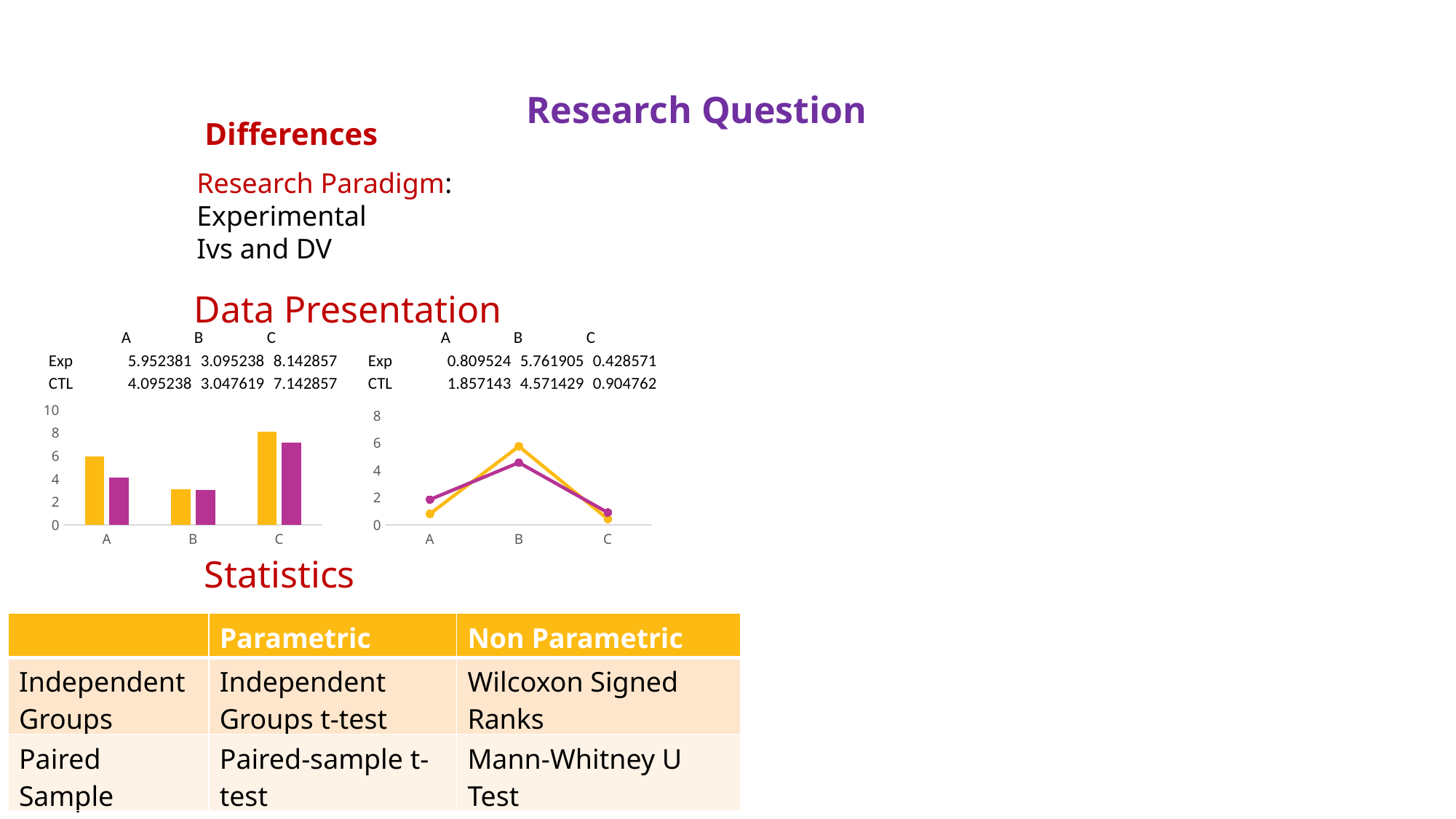
In the left bar chart, which category has the lowest CTL value? B In the left bar chart, which category has the highest Exp value? C In the left bar chart, what is the CTL value for category A? 4.095238 In the right line chart, which is larger at category A, the Exp value or the CTL value? CTL In the right line chart, what is the CTL value for category C? 0.904762 What kind of chart is the chart on the right of the slide? line chart In the right line chart, which category has the highest Exp value? B How many categories are shown on the x axis of the left bar chart? 3 In the right line chart, what is the Exp value for category B? 5.761905 In the left bar chart, what is the Exp value for category C? 8.142857 What kind of chart is the chart on the left of the slide? bar chart In the left bar chart, what is the difference between the Exp and CTL values for category C? 1